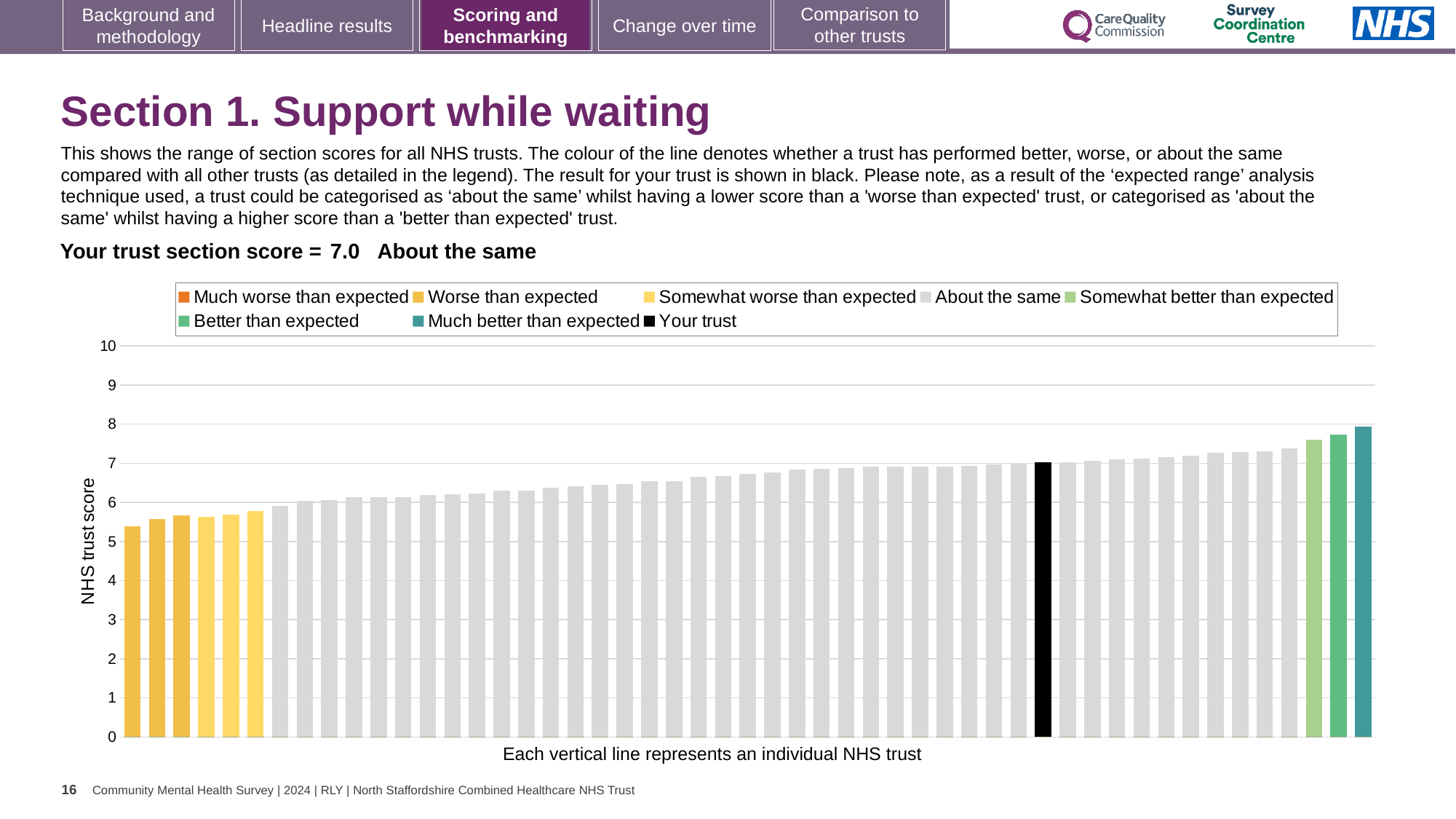
How many entries does the chart legend list? 8 What colour is used for the bar representing your trust? black How many bars are coloured as 'Worse than expected' (yellow)? 3 What kind of chart is shown on the slide? bar chart Is the value of the leftmost (lowest) bar greater or less than 6? less What is the section score for your trust shown on the slide? 7.0 Which performance category is your trust placed in for this section? About the same What is the label on the vertical axis of the chart? NHS trust score Do the bar values rise or fall from left to right along the x axis? rise How many bars are coloured as 'Much better than expected' (teal)? 1 Is the value of the black bar (your trust) greater or less than 6? greater Is the value of the rightmost (tallest) bar greater or less than 7? greater